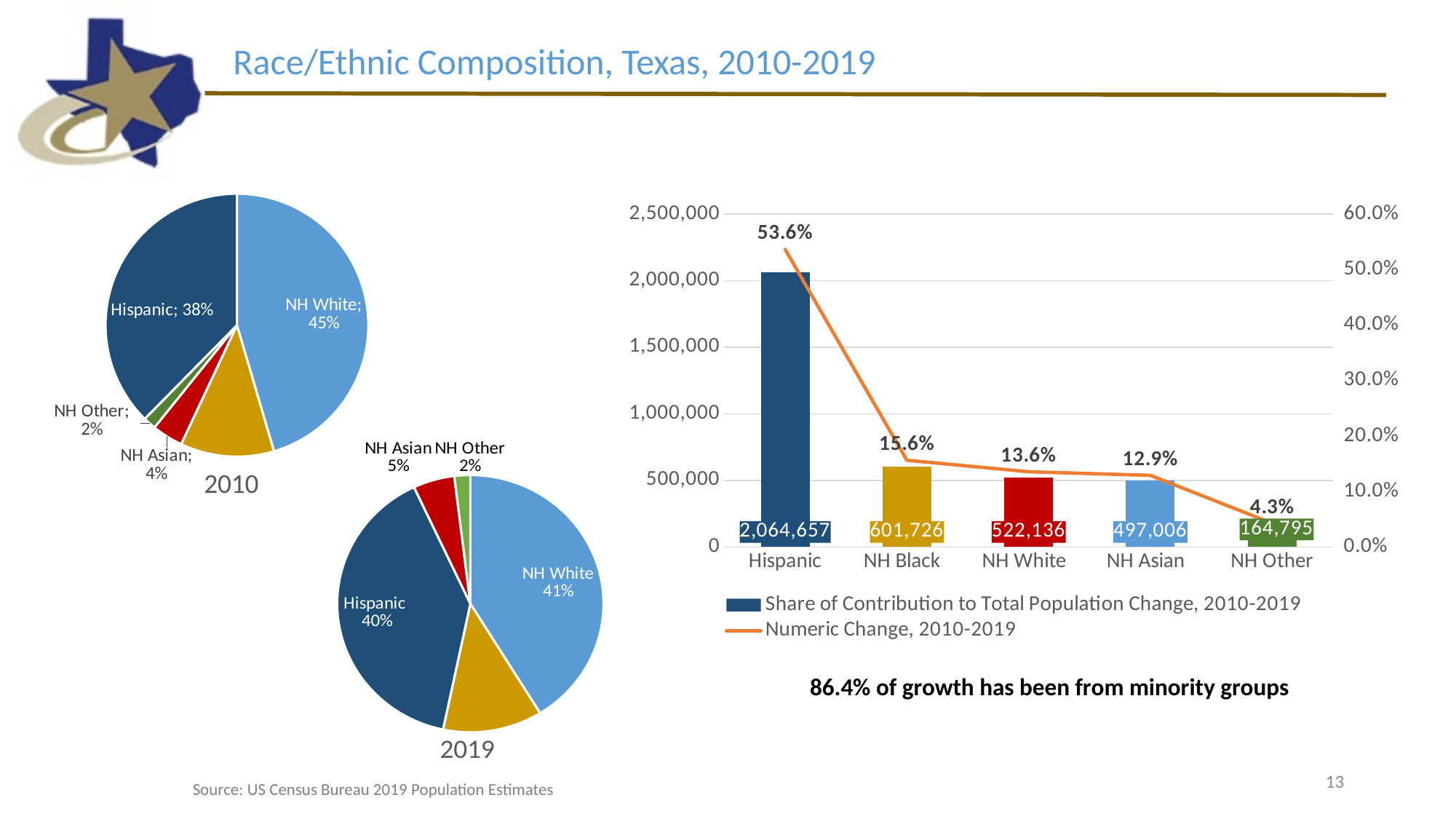
In the bar chart on the right, which category has the lowest bar? NH Other In the bar chart on the right, what percentage is shown above NH Black? 15.6% In the bar chart on the right, what is the difference between the NH Black bar value and the NH White bar value? 79,590 In the 2019 pie chart, what share is NH Asian? 5% In the bar chart on the right, what value is printed on the Hispanic bar? 2,064,657 In the bar chart on the right, what value is printed on the NH Other bar? 164,795 In the 2019 pie chart, what share is Hispanic? 40% In the 2010 pie chart, which labeled group has the largest share? NH White In the 2010 pie chart, what share is NH White? 45% In the 2010 pie chart, which labeled group has the smallest share? NH Other By how many percentage points did the Hispanic share change between the 2010 and 2019 pie charts? 2 percentage points (38% to 40%) In the bar chart on the right, how many categories are shown on the x axis? 5